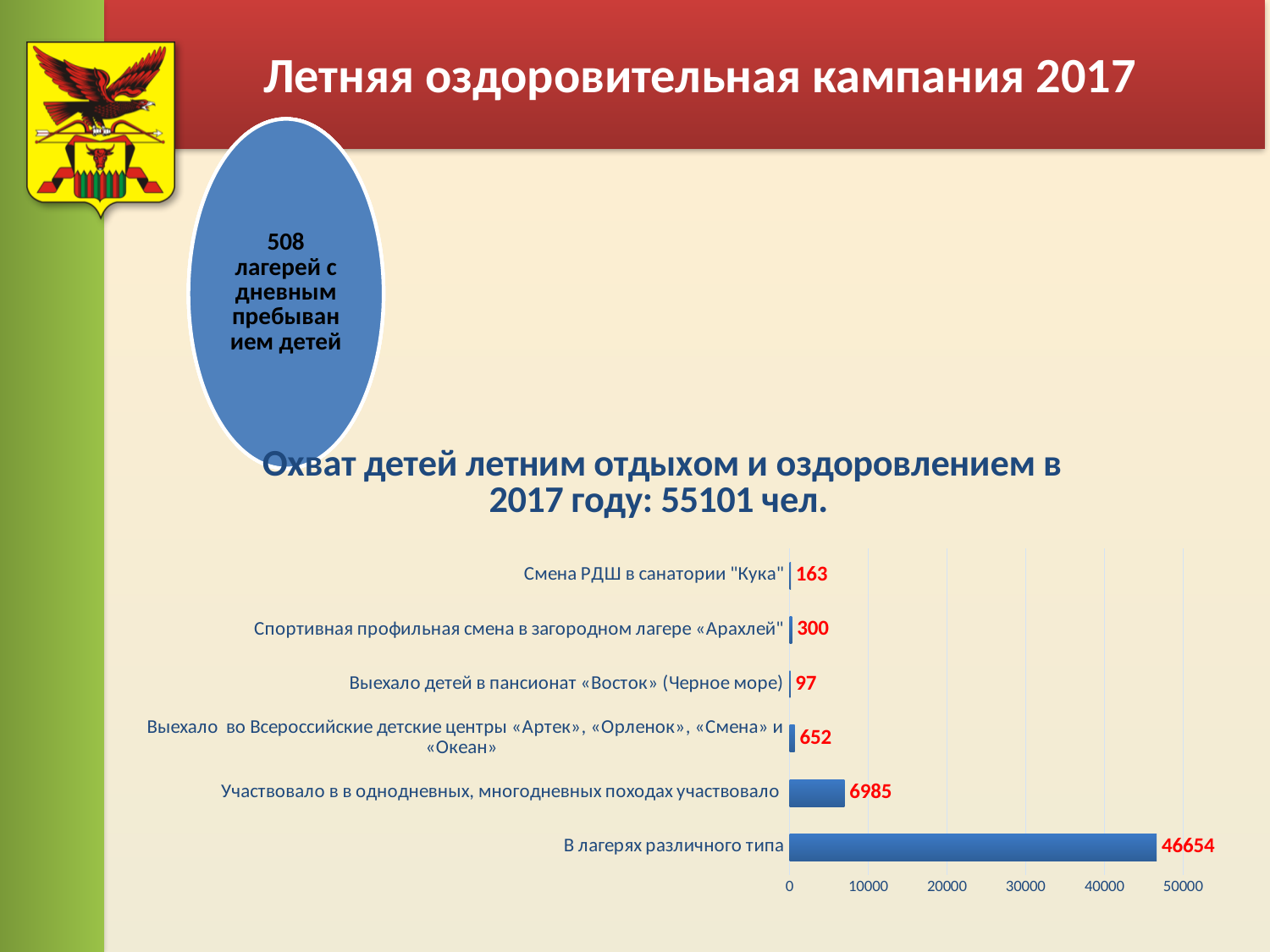
What is the value for «Выехало детей в пансионат «Восток» (Черное море)»? 97 How many categories are shown in the chart? 6 What is the difference between the values for «В лагерях различного типа» and «Участвовало в в однодневных, многодневных походах участвовало»? 39669 What is the value for «Спортивная профильная смена в загородном лагере «Арахлей»»? 300 What is the value for «Участвовало в в однодневных, многодневных походах участвовало»? 6985 What kind of chart is shown on the slide? bar chart What is the value for «В лагерях различного типа»? 46654 Which is larger: the value for «Смена РДШ в санатории "Кука"» or the value for «Выехало во Всероссийские детские центры «Артек», «Орленок», «Смена» и «Океан»»? Выехало во Всероссийские детские центры «Артек», «Орленок», «Смена» и «Океан» Is the value for «В лагерях различного типа» greater or less than 40000? greater What is the title of the chart? Охват детей летним отдыхом и оздоровлением в 2017 году: 55101 чел. Which category has the lowest value? Выехало детей в пансионат «Восток» (Черное море) Which category has the highest value? В лагерях различного типа